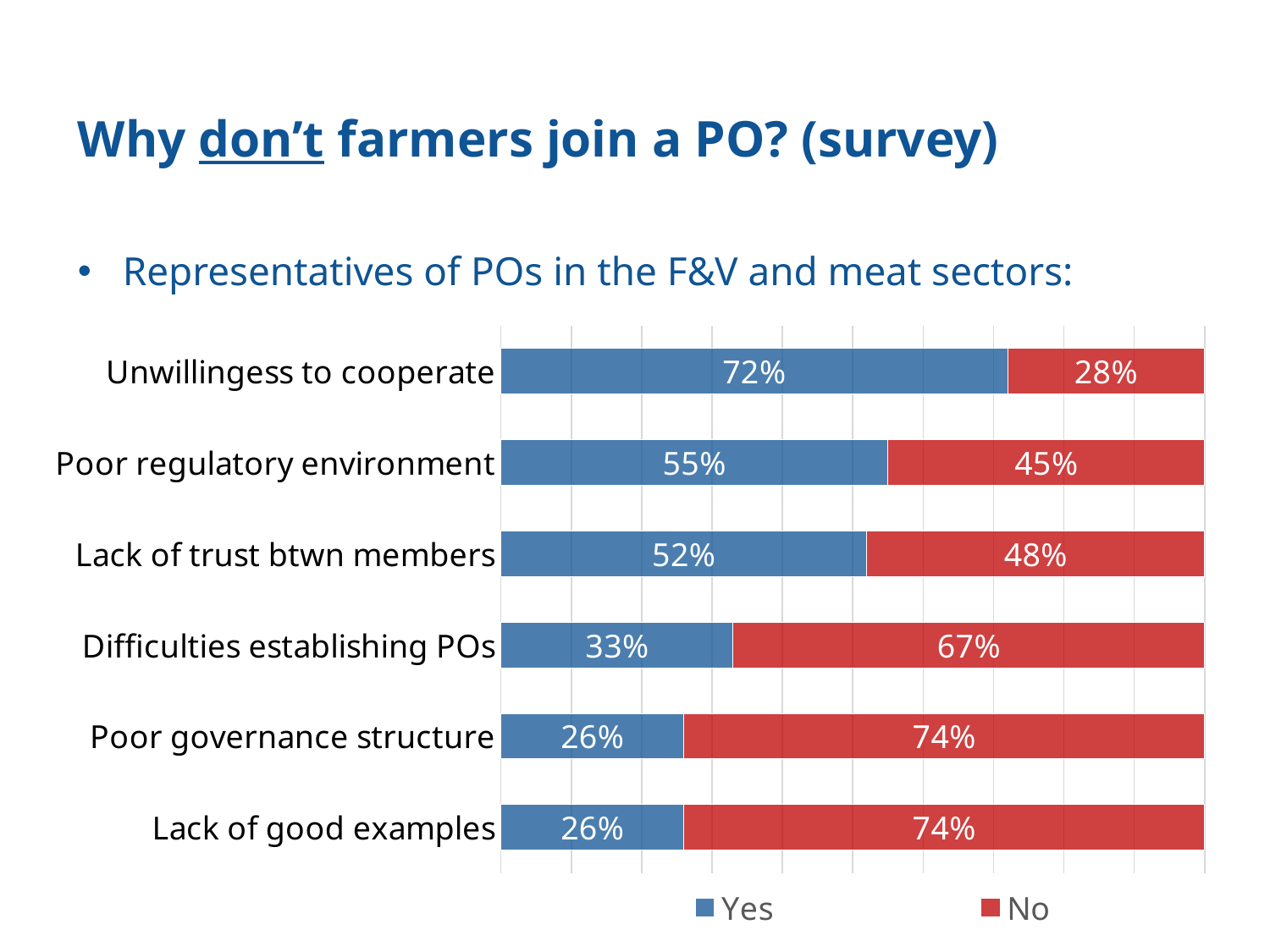
What is the difference between the "Yes" values for "Unwillingess to cooperate" and "Poor regulatory environment"? 17% Which colour represents the "No" series in the chart? Red Which category has the lowest "No" value? Unwillingess to cooperate What is the total of the stacked bar for "Poor governance structure"? 100% Which is larger: the "Yes" value for "Lack of trust btwn members" or the "Yes" value for "Difficulties establishing POs"? Lack of trust btwn members Which category has the highest "Yes" value? Unwillingess to cooperate What is the "No" value for "Poor regulatory environment"? 45% What kind of chart is shown on the slide? Stacked bar chart What is the "Yes" value for "Unwillingess to cooperate"? 72% How many categories are shown on the chart? 6 How many series does the legend list? 2 What is the "Yes" value for "Difficulties establishing POs"? 33%